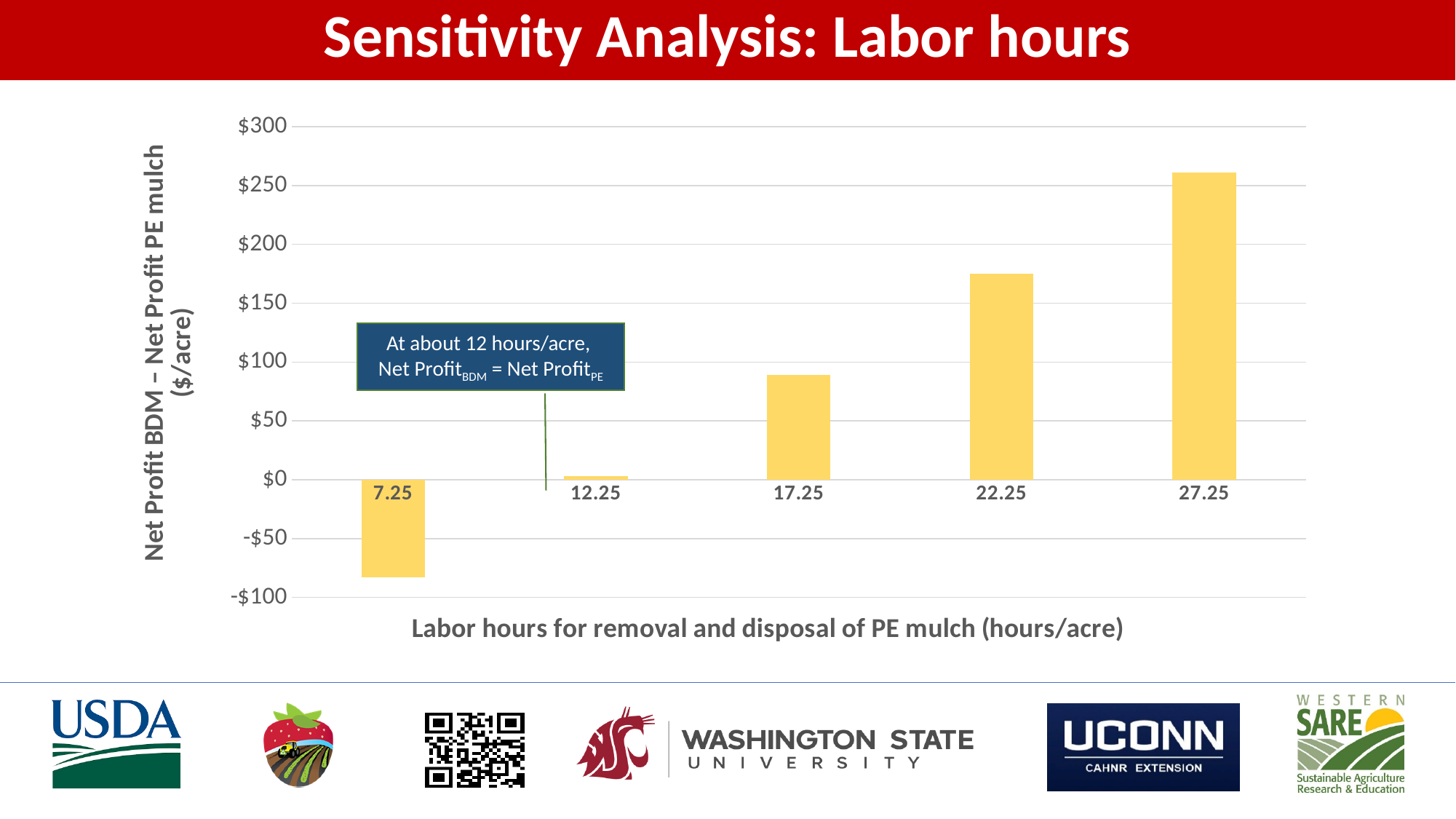
Is the value for 27.25 hours/acre greater or less than $200? greater Is the value for 22.25 hours/acre greater or less than $150? greater How many labor-hour categories are plotted on the x axis? 5 What is the x-axis title of the chart? Labor hours for removal and disposal of PE mulch (hours/acre) Is the value for 7.25 hours/acre greater or less than -$50? less Do the values rise or fall as labor hours increase along the x axis? rise Which has the larger value, 22.25 or 17.25 hours/acre? 22.25 What kind of chart is shown on the slide? bar chart Which labor-hour category has the highest value? 27.25 According to the annotation box, at about how many hours/acre does Net Profit BDM equal Net Profit PE? about 12 hours/acre Which labor-hour category has the lowest value? 7.25